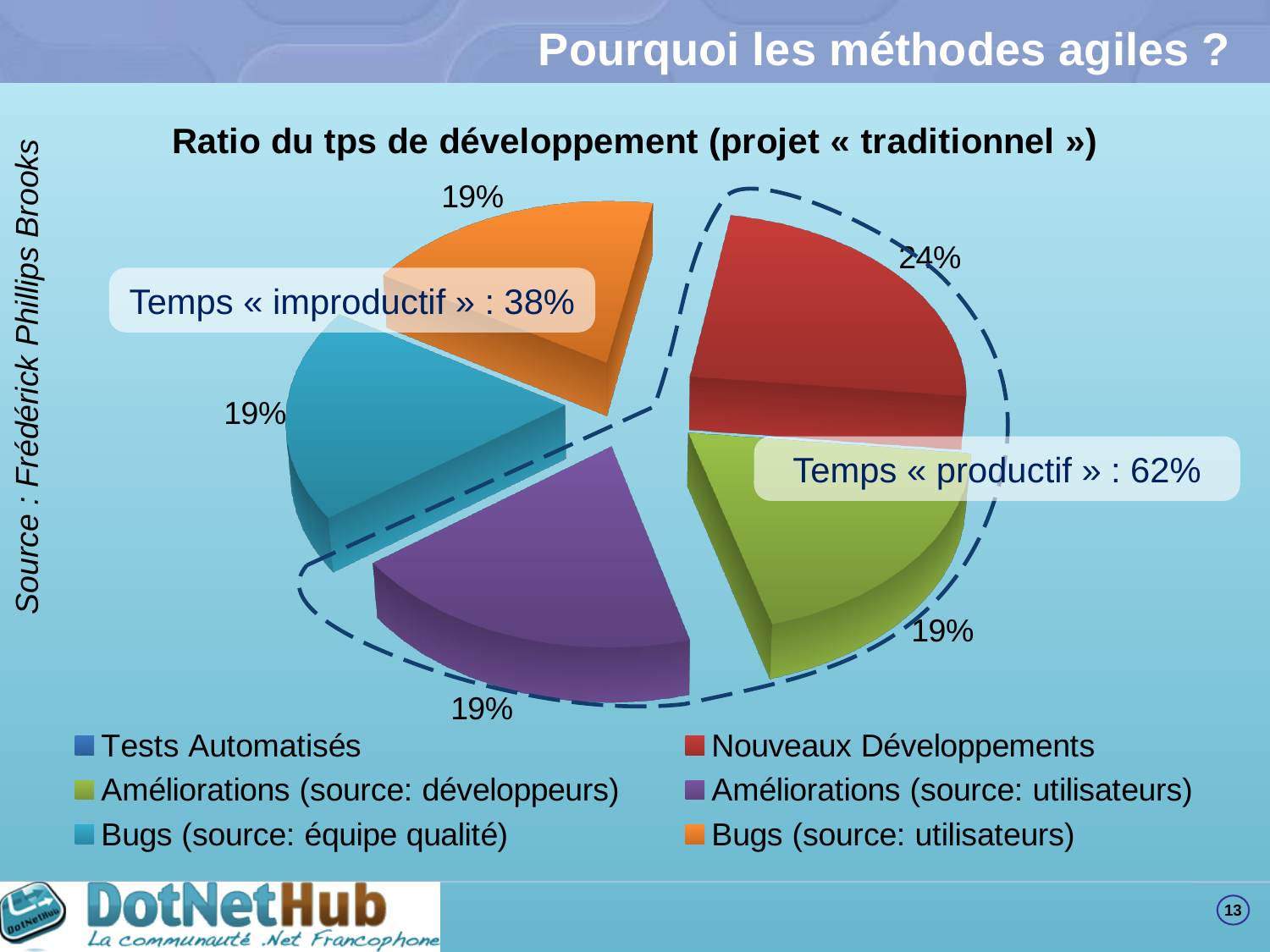
What percentage of development time is shown for Nouveaux Développements? 24% What percentage is shown for Bugs (source: utilisateurs)? 19% What percentage is shown for Améliorations (source: utilisateurs)? 19% What percentage is shown for Améliorations (source: développeurs)? 19% According to the callout on the chart, what share of time is labelled « improductif »? 38% Which is larger, the slice for Nouveaux Développements or the slice for Bugs (source: équipe qualité)? Nouveaux Développements What is the title of the chart? Ratio du tps de développement (projet « traditionnel ») Which category has the largest slice of the pie? Nouveaux Développements How many entries does the legend list? 6 How many slices are visible in the pie chart? 5 What kind of chart is shown on the slide? pie chart What is the difference in percentage points between Nouveaux Développements and Bugs (source: équipe qualité)? 5